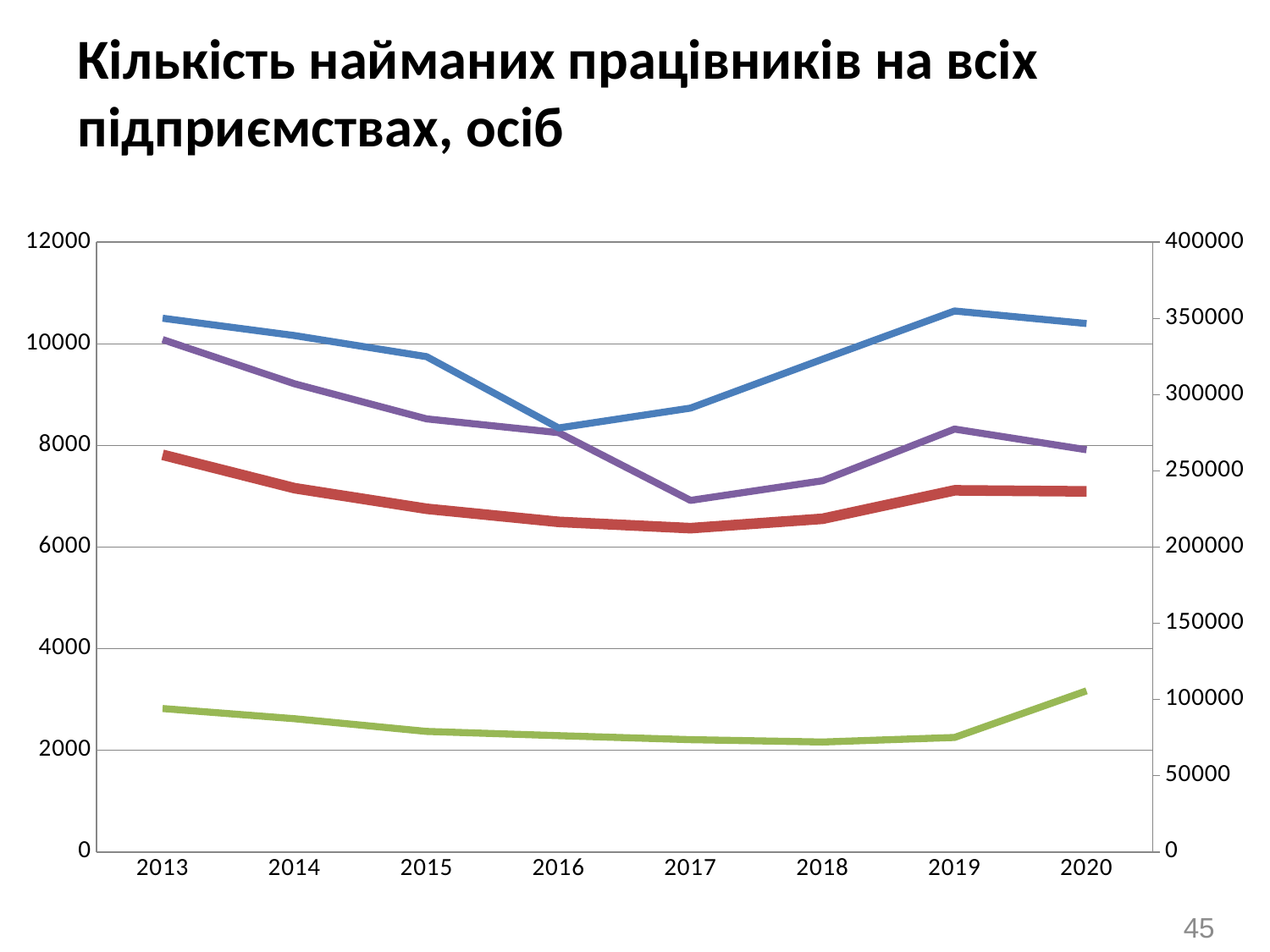
How many years are shown along the x axis of the chart? 8 In which year does the blue line reach its highest point? 2019 Does the green line rise or fall between 2019 and 2020? rise What is the title of the chart on the slide? Кількість найманих працівників на всіх підприємствах, осіб In 2013, which line is higher on the chart, the blue line or the green line? blue In which year does the blue line reach its lowest point? 2016 Does the red line rise or fall between 2013 and 2017? fall What kind of chart is shown on the slide? line chart Read against the left-hand axis, is the blue line's value in 2019 greater or less than 10000? greater Read against the left-hand axis, is the green line's value in 2020 greater or less than 4000? less In which year does the purple line reach its lowest point? 2017 How many lines are plotted on the chart? 4